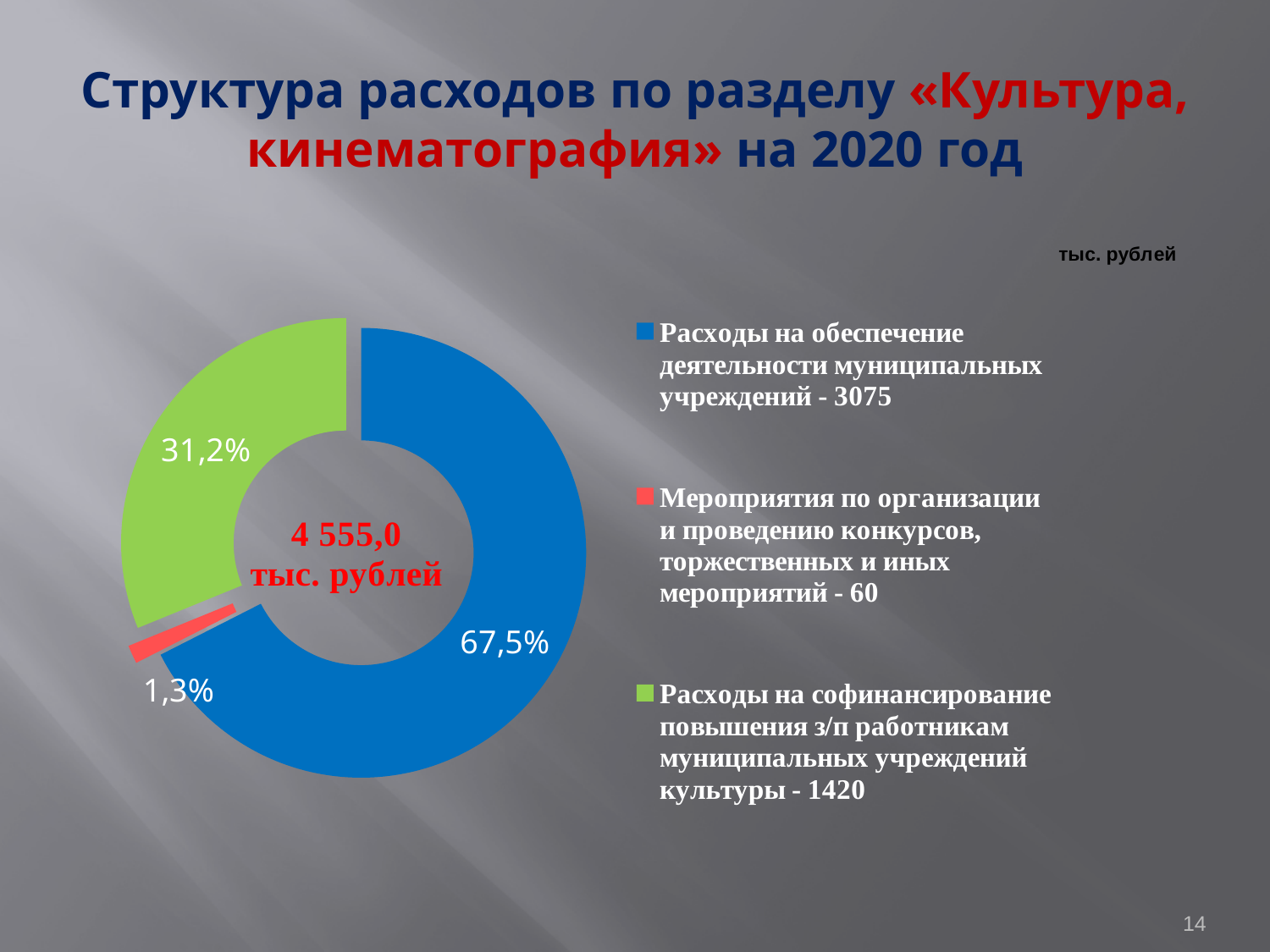
What value (in тыс. рублей) is given in the legend for Расходы на обеспечение деятельности муниципальных учреждений? 3075 Which category has the smallest share of the chart? Мероприятия по организации и проведению конкурсов, торжественных и иных мероприятий What value (in тыс. рублей) is given in the legend for Мероприятия по организации и проведению конкурсов, торжественных и иных мероприятий? 60 What percentage share is shown for the blue slice (Расходы на обеспечение деятельности муниципальных учреждений)? 67,5% How many categories does the chart show? 3 What value (in тыс. рублей) is given in the legend for Расходы на софинансирование повышения з/п работникам муниципальных учреждений культуры? 1420 What percentage share is shown for the red slice (Мероприятия по организации и проведению конкурсов, торжественных и иных мероприятий)? 1,3% Which category has the largest share of the chart? Расходы на обеспечение деятельности муниципальных учреждений What kind of chart is shown on the slide? Doughnut (pie) chart What percentage share is shown for the green slice (Расходы на софинансирование повышения з/п работникам муниципальных учреждений культуры)? 31,2% What is the difference in percentage points between the blue slice (67,5%) and the green slice (31,2%)? 36,3 What total amount is shown in the centre of the chart? 4 555,0 тыс. рублей